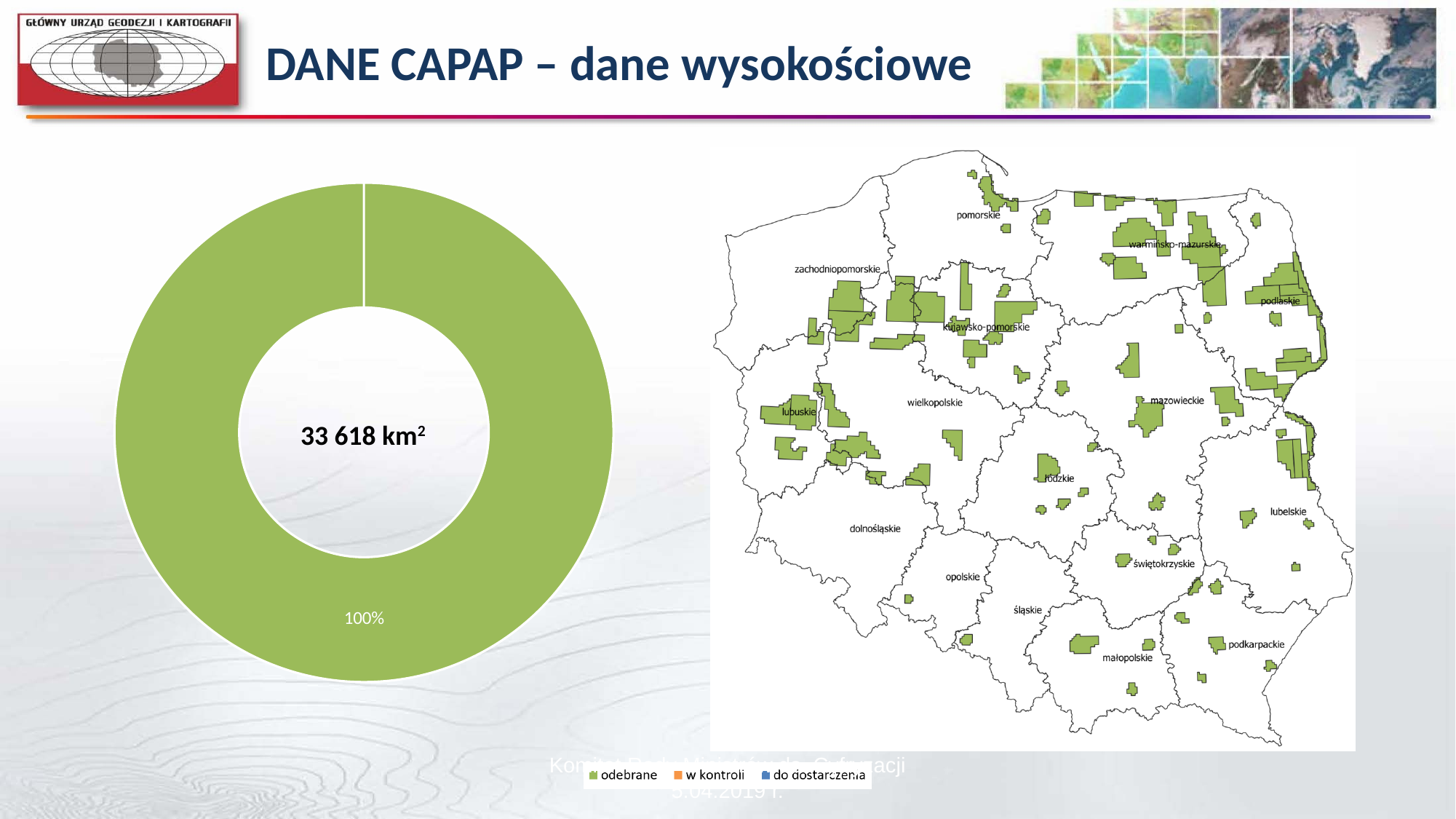
What kind of chart is shown on the left of the slide? doughnut chart What are the three categories listed in the legend of the doughnut chart? odebrane, w kontroli, do dostarczenia What value is printed in the centre of the doughnut chart? 33 618 km² How many entries does the legend of the doughnut chart list? 3 Which category has the largest share in the doughnut chart? odebrane What share of the doughnut chart does the 'odebrane' category take? 100% How many visible slices does the doughnut chart have? 1 Is the share for 'odebrane' in the doughnut chart greater or less than 50%? greater What colour represents 'odebrane' in the doughnut chart legend? green